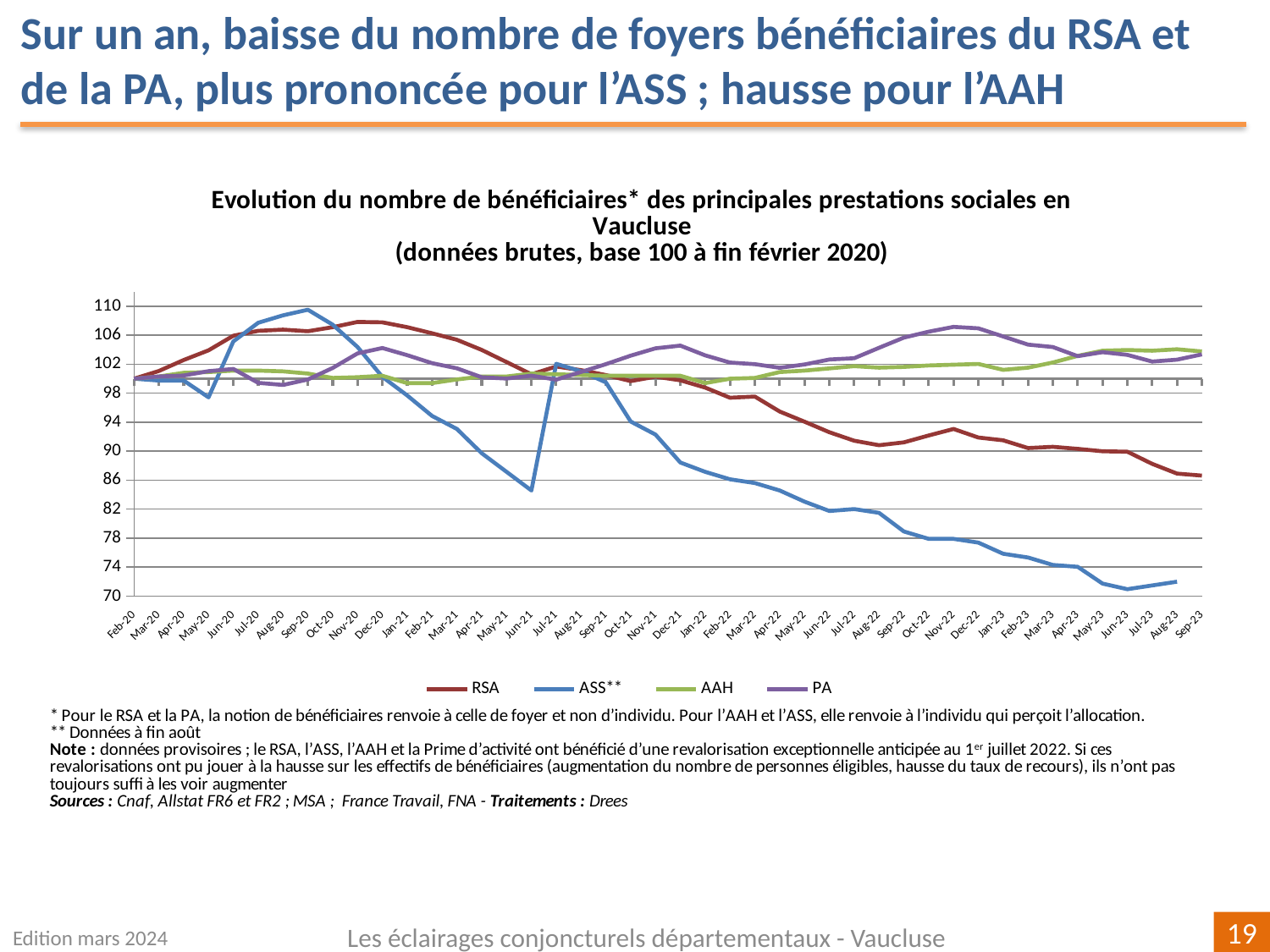
Which colour is used for the ASS** line? blue Is the value for RSA at Sep-23 greater or less than 90? less What kind of chart is shown on the slide? line chart Is the value for AAH at Sep-23 greater or less than 102? greater Does the ASS** line rise or fall overall from Feb-20 to Sep-23? fall Is the value for ASS** at Jun-21 greater or less than 86? less How many series does the legend list? 4 Which series are listed in the legend? RSA, ASS**, AAH, PA Which series has the lowest value at Sep-23? RSA